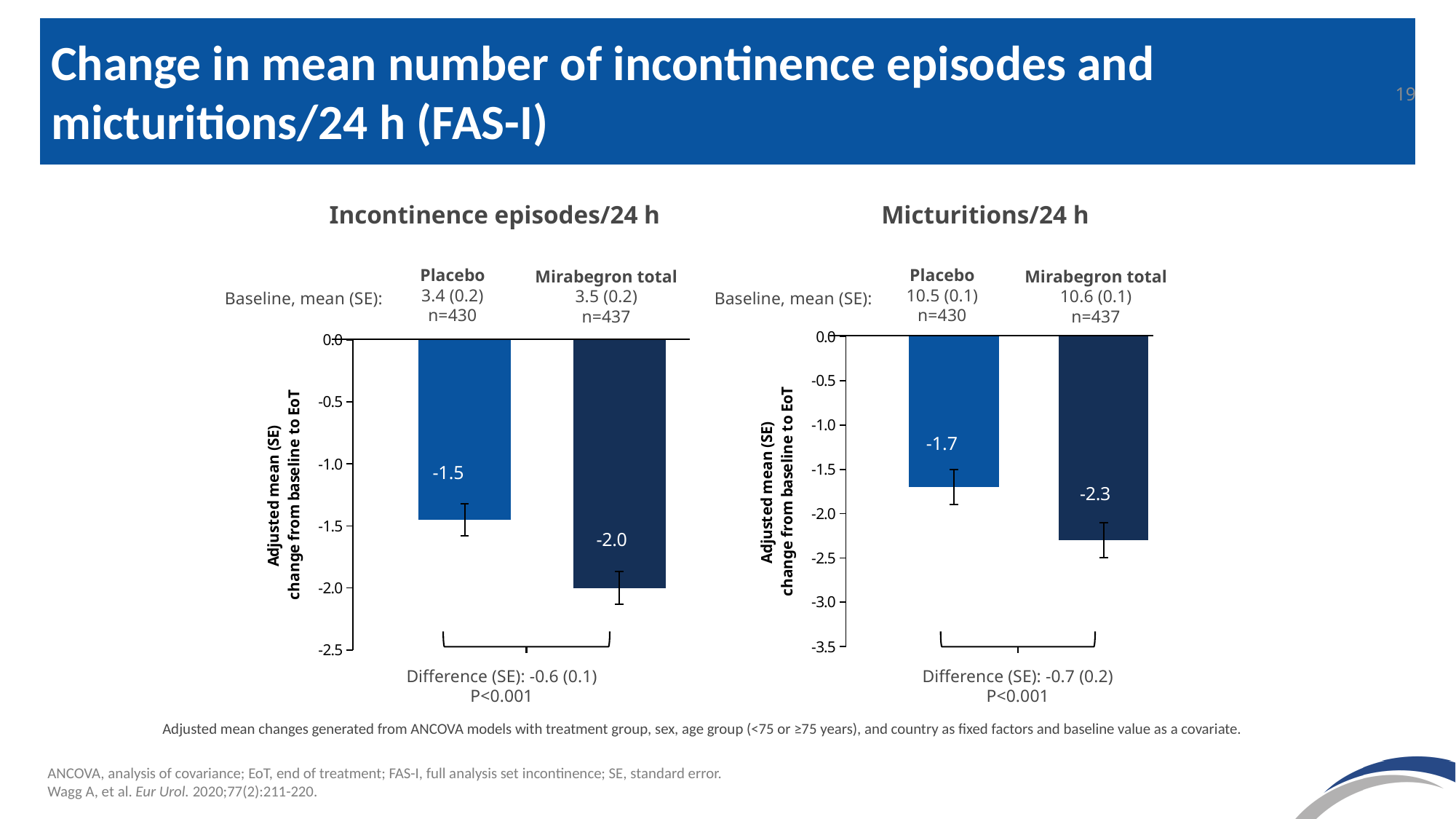
In the Micturitions/24 h chart, what is the adjusted mean change from baseline for Mirabegron total? -2.3 What kind of chart is the Incontinence episodes/24 h chart? bar chart In the Incontinence episodes/24 h chart, what is the adjusted mean change from baseline for Placebo? -1.5 In the Incontinence episodes/24 h chart, what is the printed Difference (SE) between the groups? -0.6 (0.1) In the Micturitions/24 h chart, what is the adjusted mean change from baseline for Placebo? -1.7 How many bars are plotted in the Micturitions/24 h chart? 2 In the Incontinence episodes/24 h chart, what is the adjusted mean change from baseline for Mirabegron total? -2.0 In the Micturitions/24 h chart, which group shows the larger reduction from baseline, Placebo or Mirabegron total? Mirabegron total In the Micturitions/24 h chart, is the value for Mirabegron total greater or less than -3.0? greater In the Incontinence episodes/24 h chart, is the value for Placebo greater or less than -1.0? less In the Micturitions/24 h chart, what is the baseline mean (SE) for Placebo? 10.5 (0.1) In the Incontinence episodes/24 h chart, which group has the lowest (most negative) adjusted mean change? Mirabegron total